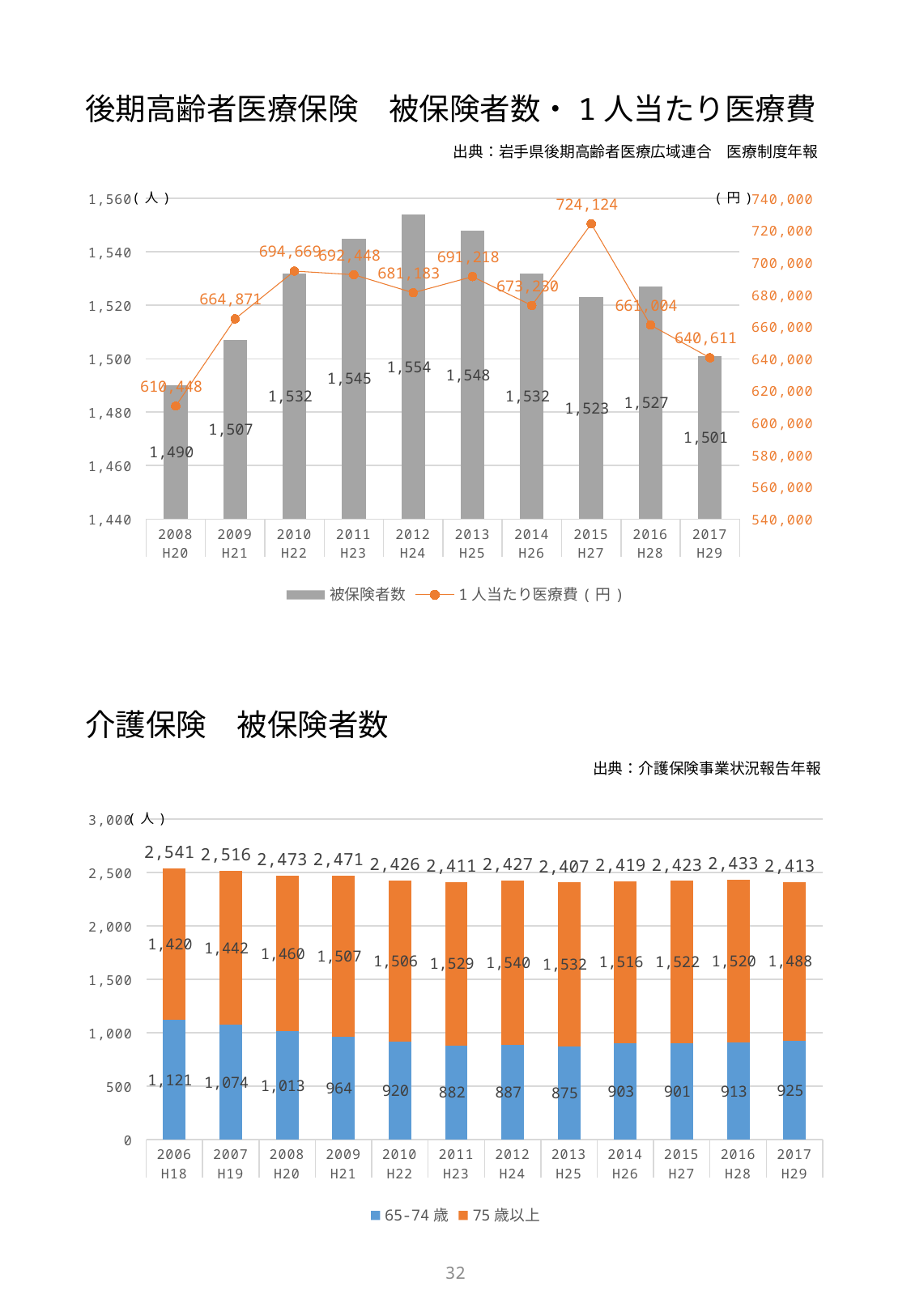
In the bottom chart (介護保険 被保険者数), what is the total of the stacked bar for 2006 (H18)? 2,541 In the bottom chart (介護保険 被保険者数), what is the 65-74歳 value for 2013 (H25)? 875 In the top chart (後期高齢者医療保険 被保険者数・1人当たり医療費), what is the 被保険者数 value for 2012 (H24)? 1,554 In the top chart (後期高齢者医療保険 被保険者数・1人当たり医療費), how many years are shown on the x axis? 10 In the top chart (後期高齢者医療保険 被保険者数・1人当たり医療費), which year has the highest 被保険者数? 2012 (H24) In the top chart (後期高齢者医療保険 被保険者数・1人当たり医療費), what is the difference in 被保険者数 between 2012 (H24) and 2017 (H29)? 53 In the top chart (後期高齢者医療保険 被保険者数・1人当たり医療費), how many series does the legend list? 2 In the top chart (後期高齢者医療保険 被保険者数・1人当たり医療費), what is the 1人当たり医療費 value for 2015 (H27)? 724,124 In the bottom chart (介護保険 被保険者数), which year has the highest 75歳以上 value? 2012 (H24) In the top chart (後期高齢者医療保険 被保険者数・1人当たり医療費), which year has the lowest 1人当たり医療費? 2008 (H20) What kind of chart is the bottom chart (介護保険 被保険者数)? stacked bar chart In the bottom chart (介護保険 被保険者数), is the 65-74歳 value for 2009 (H21) larger or smaller than the 65-74歳 value for 2017 (H29)? larger